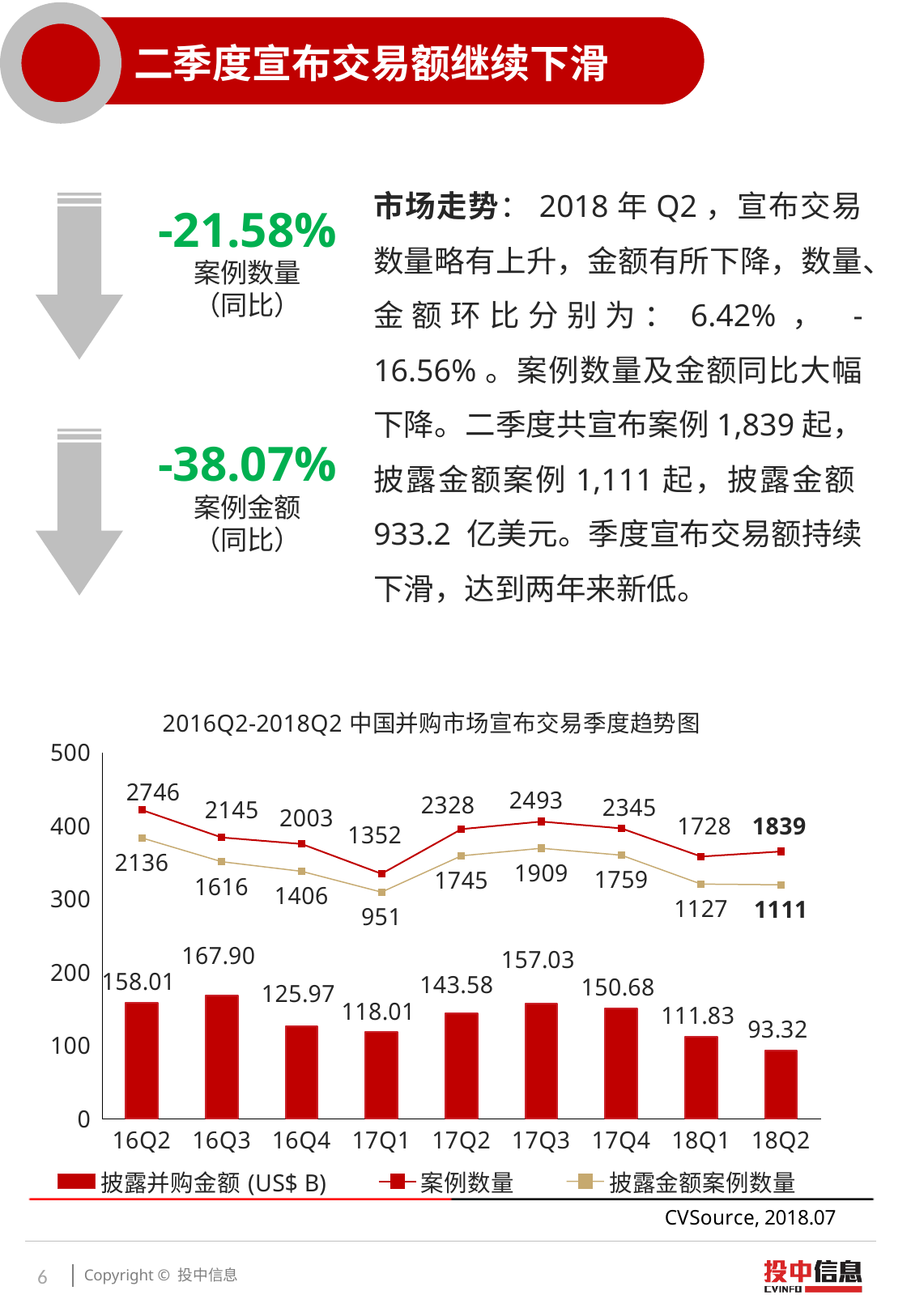
Is the 披露并购金额 (US$ B) bar for 17Q2 greater or less than 100? greater Which is larger, the 案例数量 for 17Q3 or for 17Q4? 17Q3 What is the 披露并购金额 (US$ B) value for 18Q2? 93.32 How many series does the legend list? 3 What is the difference in 披露并购金额 (US$ B) between 18Q1 and 18Q2? 18.51 What is the 案例数量 value for 16Q2? 2746 Which quarter has the lowest 案例数量? 17Q1 What is the 披露金额案例数量 value for 17Q1? 951 What kind of chart is this? Combined bar and line chart Which quarter has the highest 披露并购金额 (US$ B)? 16Q3 What is the title of the chart? 2016Q2-2018Q2 中国并购市场宣布交易季度趋势图 How many quarters are shown on the x axis? 9